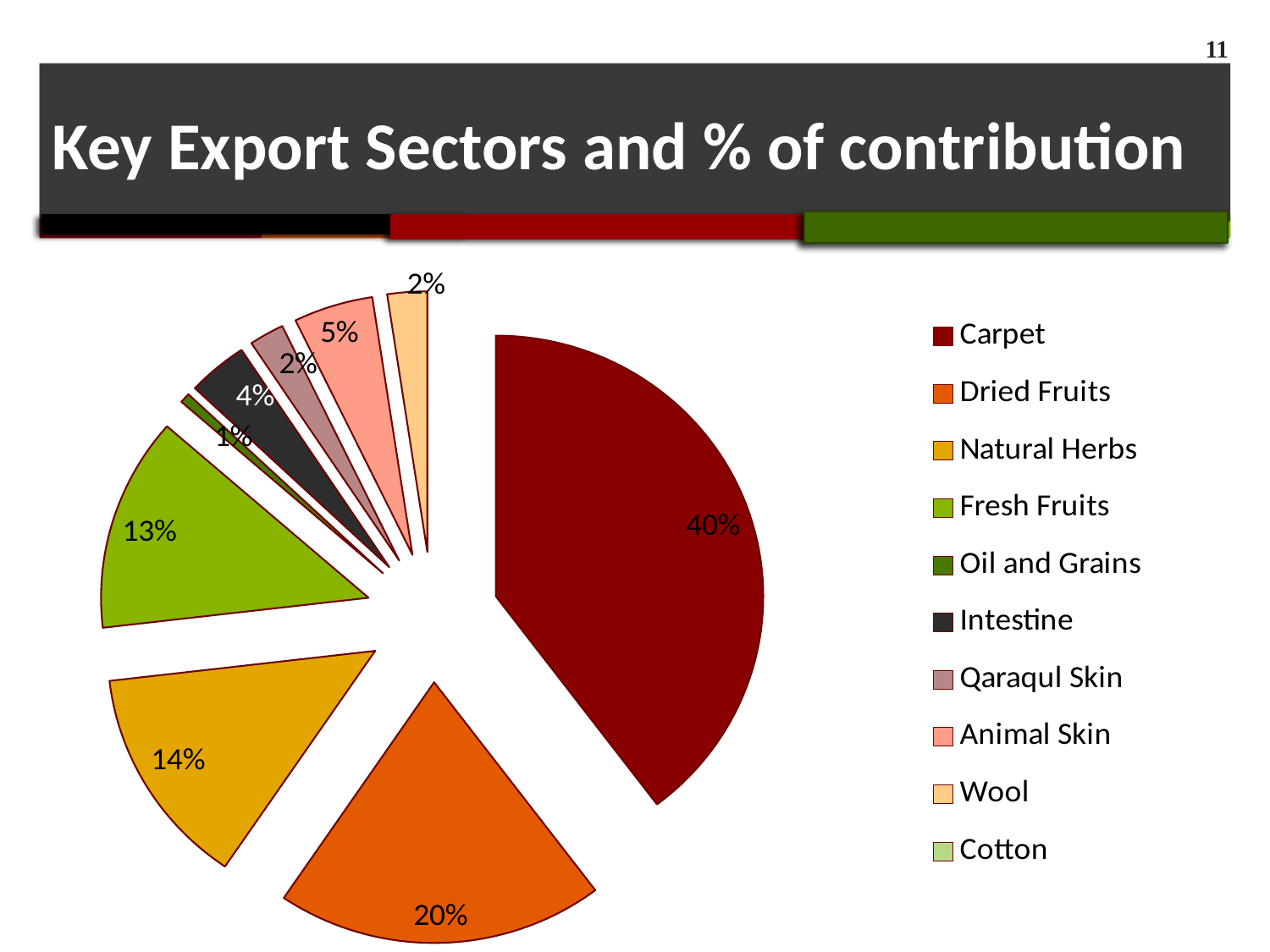
What percentage of contribution does Intestine have? 4% What percentage of contribution does Dried Fruits have? 20% What is the difference in percentage points between Carpet and Dried Fruits? 20 What percentage of contribution does Carpet have? 40% How many export sectors are listed in the legend? 10 What percentage of contribution does Natural Herbs have? 14% What percentage of contribution does Animal Skin have? 5% What is the title of the slide's chart? Key Export Sectors and % of contribution Which has a larger share, Natural Herbs or Fresh Fruits? Natural Herbs Which export sector has the largest share of the pie? Carpet What kind of chart is shown on the slide? pie chart What percentage of contribution does Fresh Fruits have? 13%